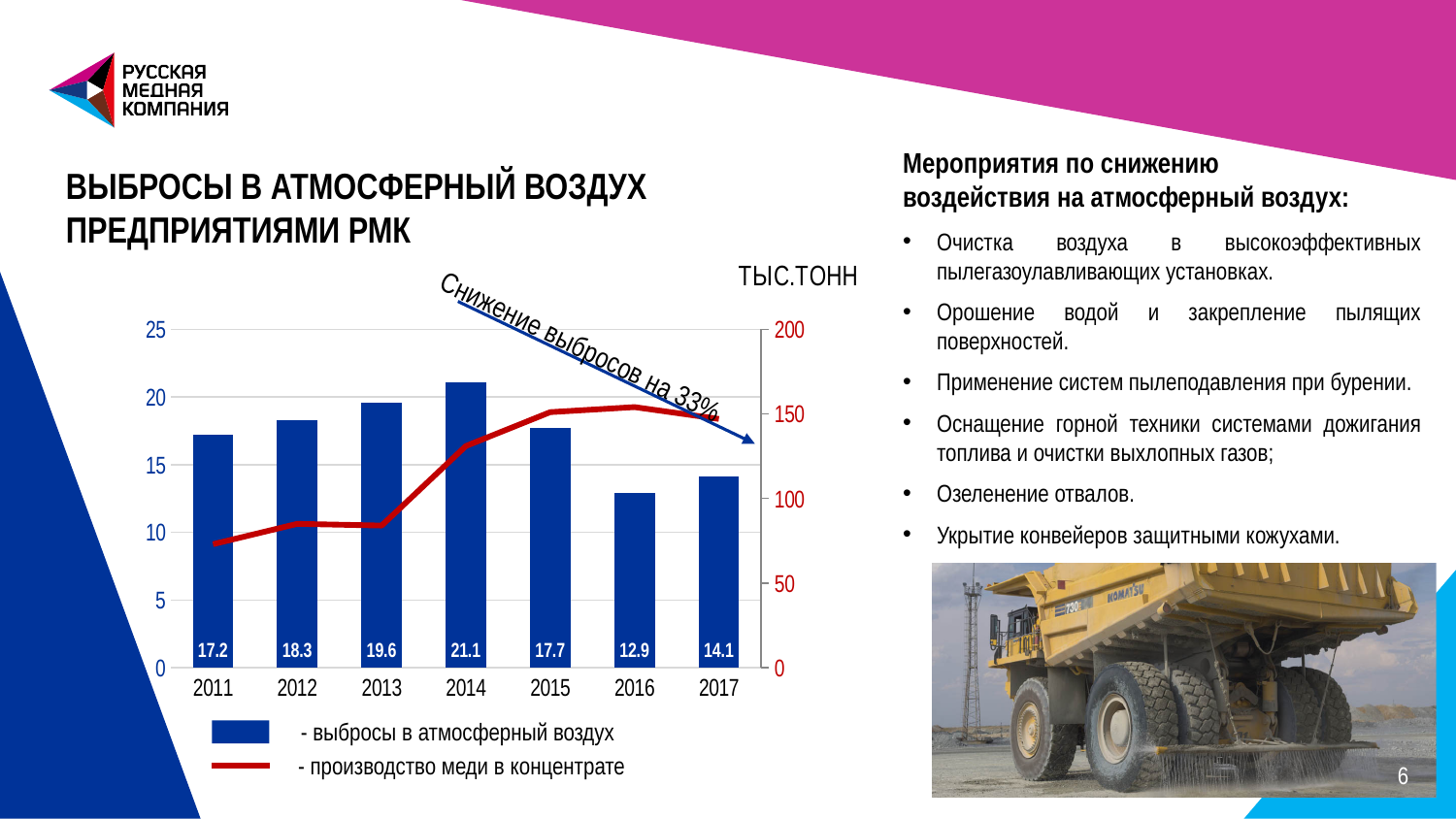
What percentage reduction in emissions is annotated on the chart? 33% What is the value of emissions into the atmosphere for 2011? 17.2 What is the value of emissions into the atmosphere for 2016? 12.9 Which year has higher emissions into the atmosphere, 2012 or 2017? 2012 How many series does the chart legend list? 2 Which year has the lowest emissions into the atmosphere? 2016 Is the copper production in concentrate value for 2011 greater or less than 100? less What is the difference between emissions in 2014 and emissions in 2016? 8.2 How many years are shown on the x axis of the chart? 7 Which year has the highest emissions into the atmosphere? 2014 What is the value of emissions into the atmosphere (выбросы в атмосферный воздух) for 2014? 21.1